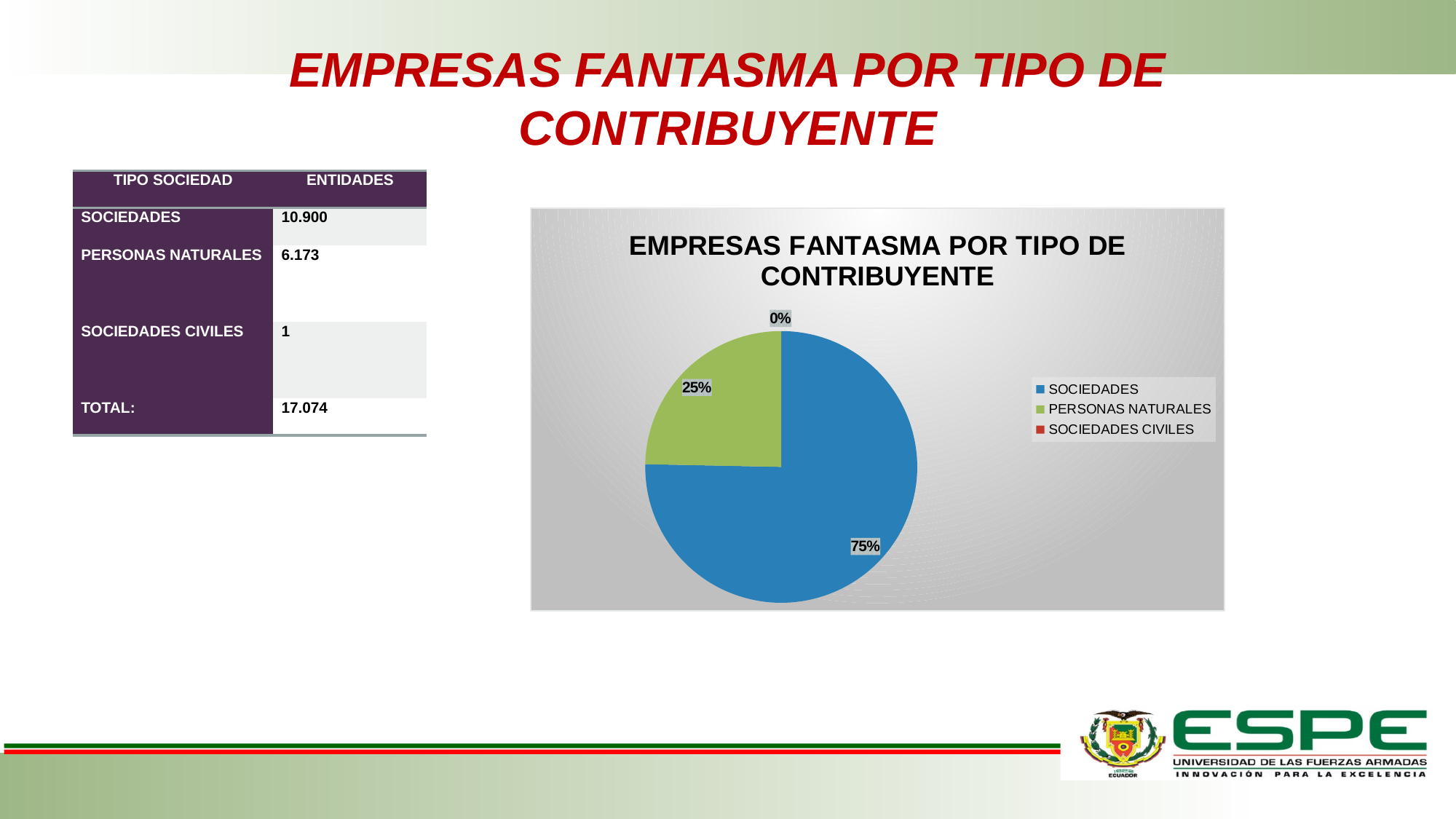
What share of the pie does SOCIEDADES CIVILES represent? 0% Is the share for SOCIEDADES greater or less than 50%? greater Which category has the smallest slice of the pie? SOCIEDADES CIVILES What share of the pie does SOCIEDADES represent? 75% What is the difference in percentage points between the SOCIEDADES share and the PERSONAS NATURALES share? 50% What share of the pie does PERSONAS NATURALES represent? 25% Which is larger, the share for SOCIEDADES or the share for PERSONAS NATURALES? SOCIEDADES Which category has the largest slice of the pie? SOCIEDADES What is the title of the chart? EMPRESAS FANTASMA POR TIPO DE CONTRIBUYENTE How many categories does the legend list? 3 What kind of chart is shown on the slide? pie chart What colour is the slice for PERSONAS NATURALES? green